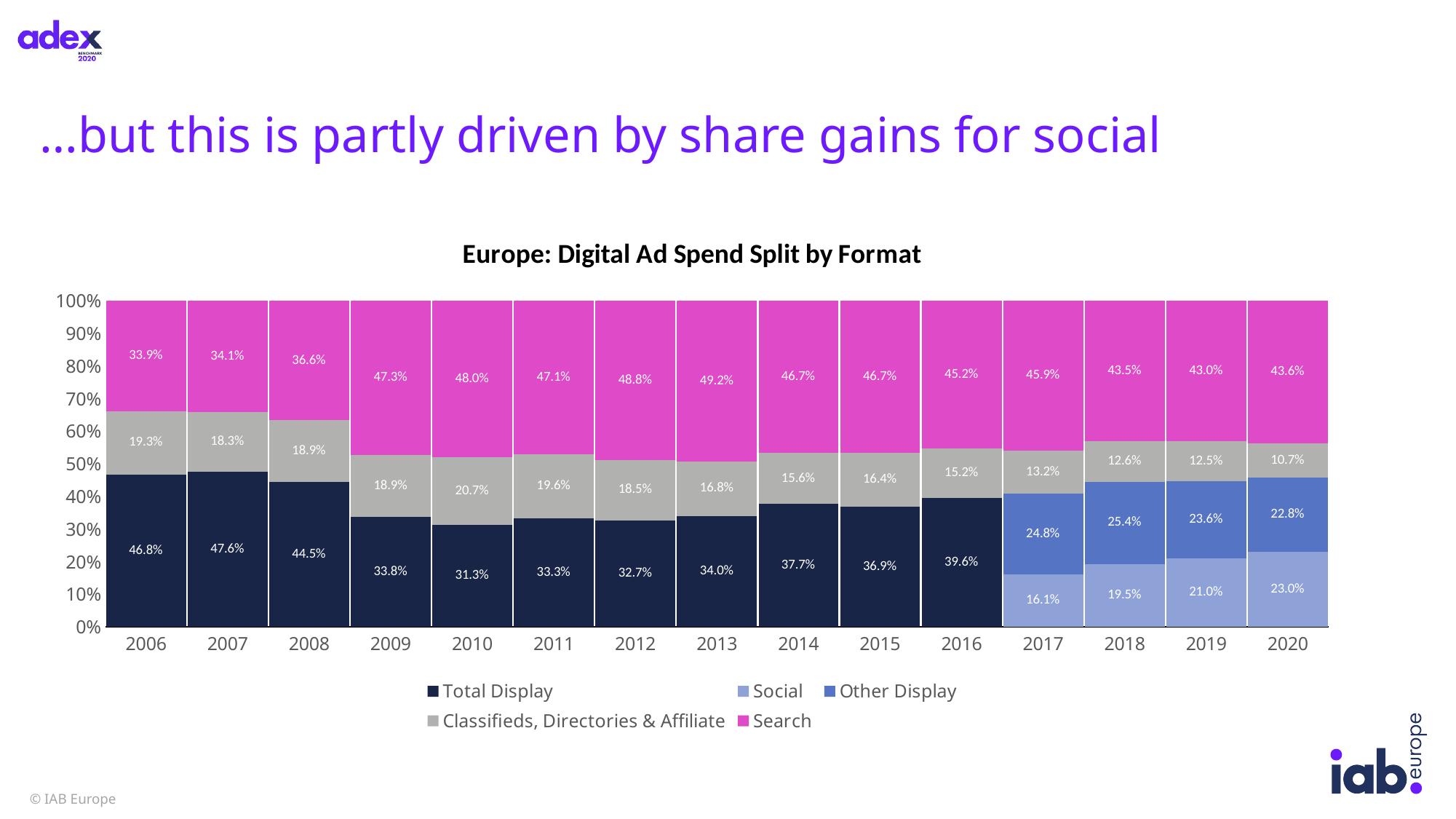
In which year is the Total Display share lowest? 2010 What kind of chart is shown? Stacked bar chart What is the Search share of digital ad spend in 2020? 43.6% In which year is the Search share highest? 2013 How many years are shown on the x axis? 15 In 2017, which is larger: the Social share or the Other Display share? Other Display What is the Other Display share in 2018? 25.4% By how many percentage points did the Social share grow from 2017 to 2020? 6.9 percentage points How many series does the legend list? 5 What is the Social share in 2017? 16.1% Does the Classifieds, Directories & Affiliate share rise or fall from 2017 to 2020? Fall What is the Classifieds, Directories & Affiliate share in 2010? 20.7%